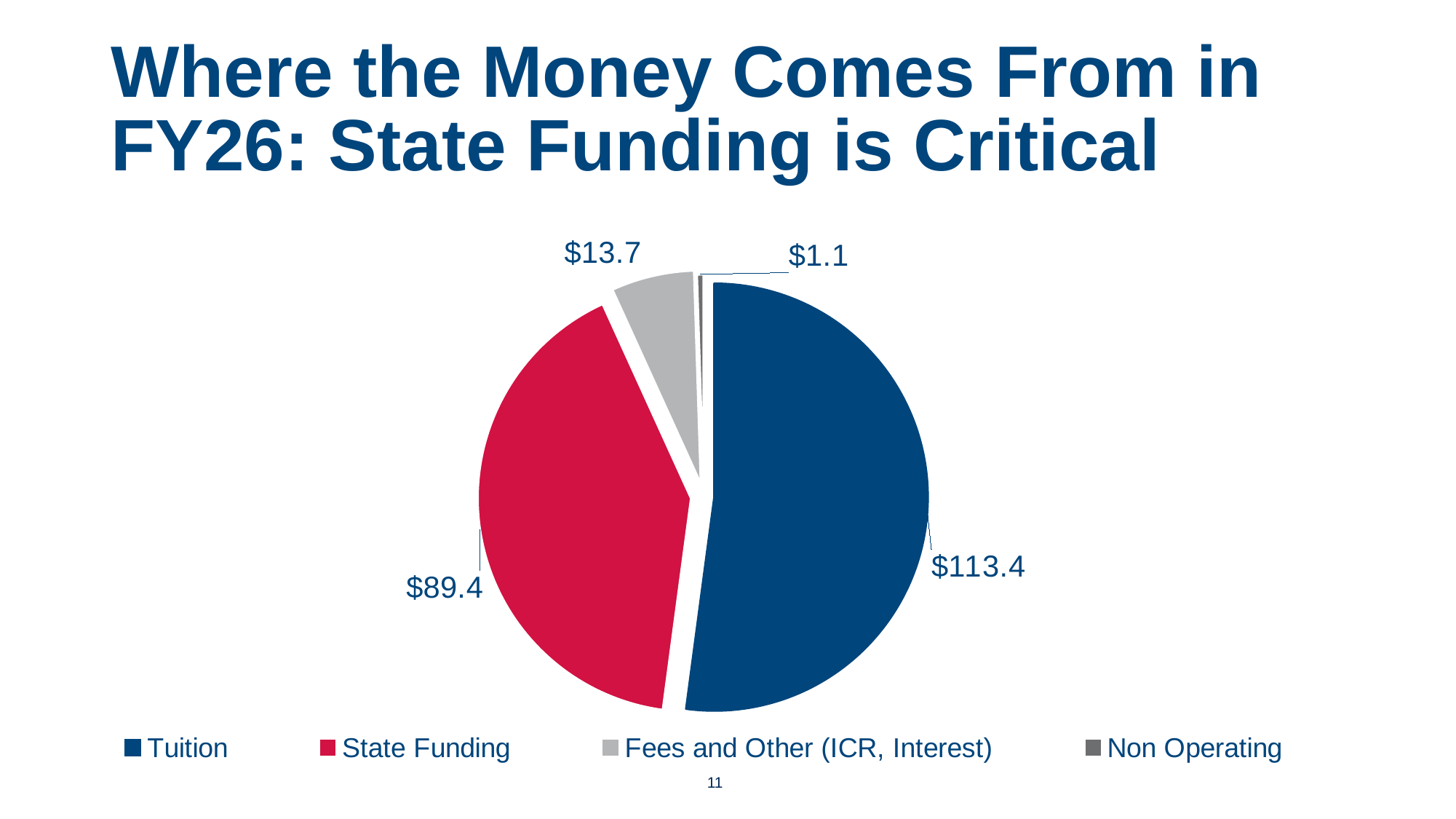
What is the difference between the Tuition value and the State Funding value? $24.0 How many categories does the pie chart show? 4 What is the total of all four slices in the pie chart? $217.6 Which is larger, State Funding or Fees and Other (ICR, Interest)? State Funding What colour is the State Funding slice? Red What is the value for State Funding? $89.4 Which category has the largest slice of the pie? Tuition What is the value for Fees and Other (ICR, Interest)? $13.7 What is the value for Non Operating? $1.1 What is the value for Tuition? $113.4 What kind of chart is shown on the slide? Pie chart Which category has the smallest slice of the pie? Non Operating